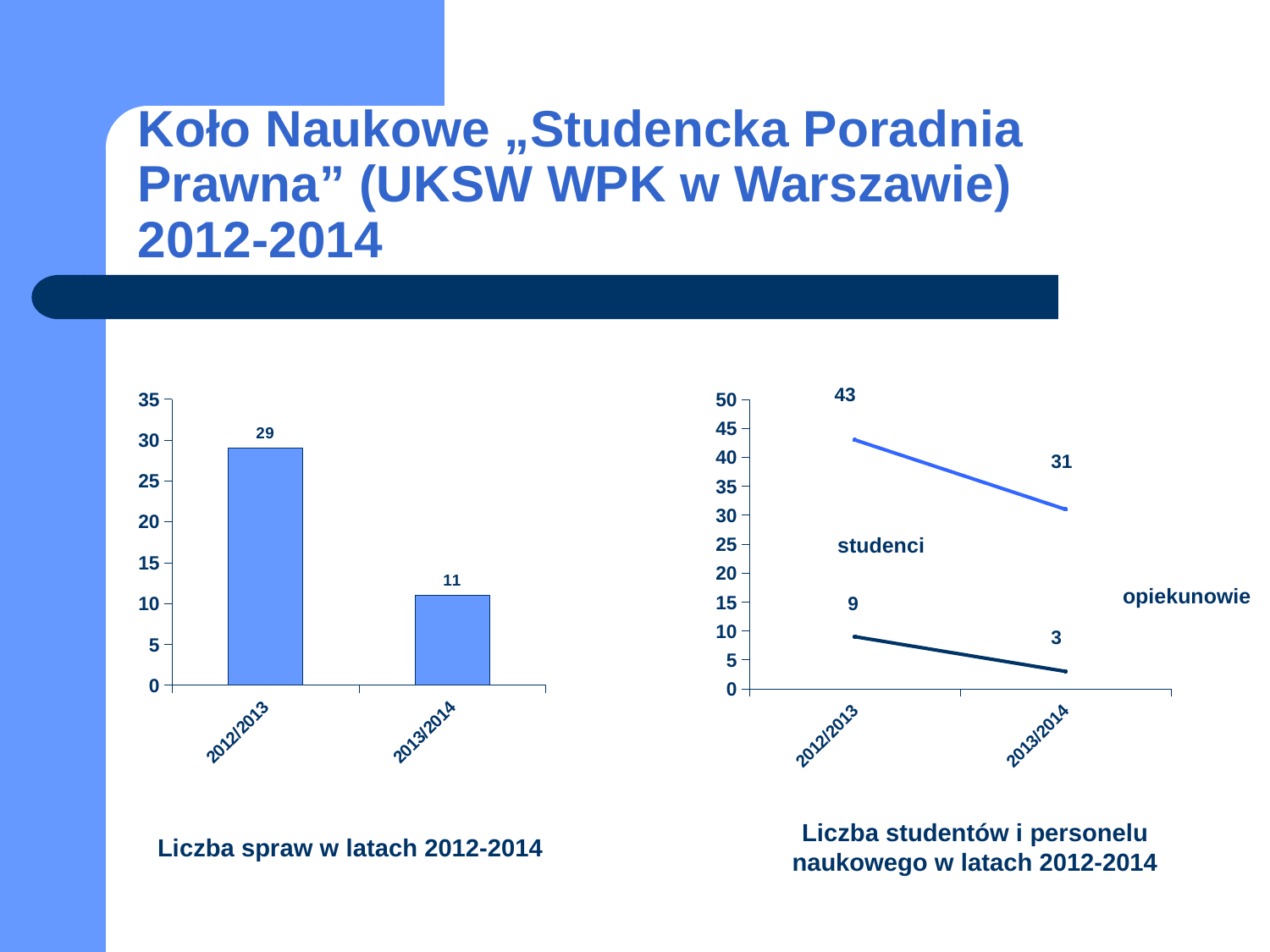
In the right chart (Liczba studentów i personelu naukowego w latach 2012-2014), what is the value for opiekunowie in 2013/2014? 3 In the right chart (Liczba studentów i personelu naukowego w latach 2012-2014), do the values for opiekunowie rise or fall from 2012/2013 to 2013/2014? fall In the left chart (Liczba spraw w latach 2012-2014), which year has the higher value? 2012/2013 What kind of chart is the right chart (Liczba studentów i personelu naukowego w latach 2012-2014)? line chart In the right chart (Liczba studentów i personelu naukowego w latach 2012-2014), by how much did the studenci value fall from 2012/2013 to 2013/2014? 12 In the left chart (Liczba spraw w latach 2012-2014), what is the value for 2013/2014? 11 In the right chart (Liczba studentów i personelu naukowego w latach 2012-2014), which series has the higher value in 2012/2013, studenci or opiekunowie? studenci In the left chart (Liczba spraw w latach 2012-2014), what is the value for 2012/2013? 29 What kind of chart is the left chart (Liczba spraw w latach 2012-2014)? bar chart In the left chart (Liczba spraw w latach 2012-2014), what is the difference between the 2012/2013 and 2013/2014 values? 18 How many series are plotted in the right chart (Liczba studentów i personelu naukowego w latach 2012-2014)? 2 In the right chart (Liczba studentów i personelu naukowego w latach 2012-2014), what is the value for studenci in 2012/2013? 43